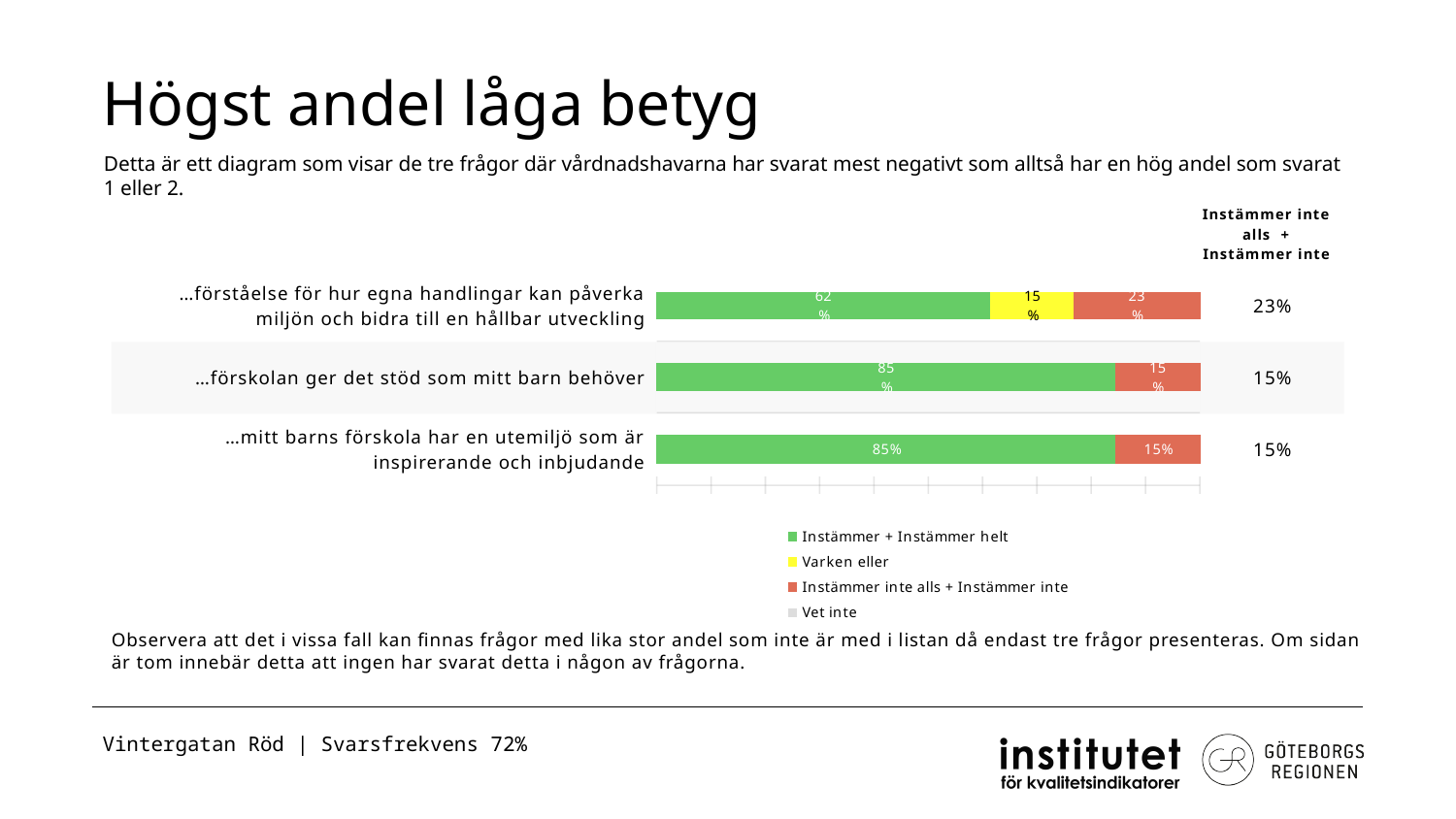
What kind of chart is shown on the slide? Stacked bar chart What is the value of 'Varken eller' for '…förståelse för hur egna handlingar kan påverka miljön och bidra till en hållbar utveckling'? 15% Which colour represents 'Varken eller' in the legend? Yellow What is the difference between the 'Instämmer + Instämmer helt' values for '…förskolan ger det stöd som mitt barn behöver' and '…förståelse för hur egna handlingar kan påverka miljön och bidra till en hållbar utveckling'? 23% What is the value of 'Instämmer + Instämmer helt' for '…förståelse för hur egna handlingar kan påverka miljön och bidra till en hållbar utveckling'? 62% Which category has the highest 'Instämmer inte alls + Instämmer inte' value? …förståelse för hur egna handlingar kan påverka miljön och bidra till en hållbar utveckling Which category has the lowest 'Instämmer + Instämmer helt' value? …förståelse för hur egna handlingar kan påverka miljön och bidra till en hållbar utveckling What is the value of 'Instämmer + Instämmer helt' for '…förskolan ger det stöd som mitt barn behöver'? 85% How many categories (questions) are plotted in the chart? 3 What is the value of 'Instämmer inte alls + Instämmer inte' for '…mitt barns förskola har en utemiljö som är inspirerande och inbjudande'? 15% What is the value of 'Instämmer inte alls + Instämmer inte' for '…förståelse för hur egna handlingar kan påverka miljön och bidra till en hållbar utveckling'? 23% How many series does the legend list? 4